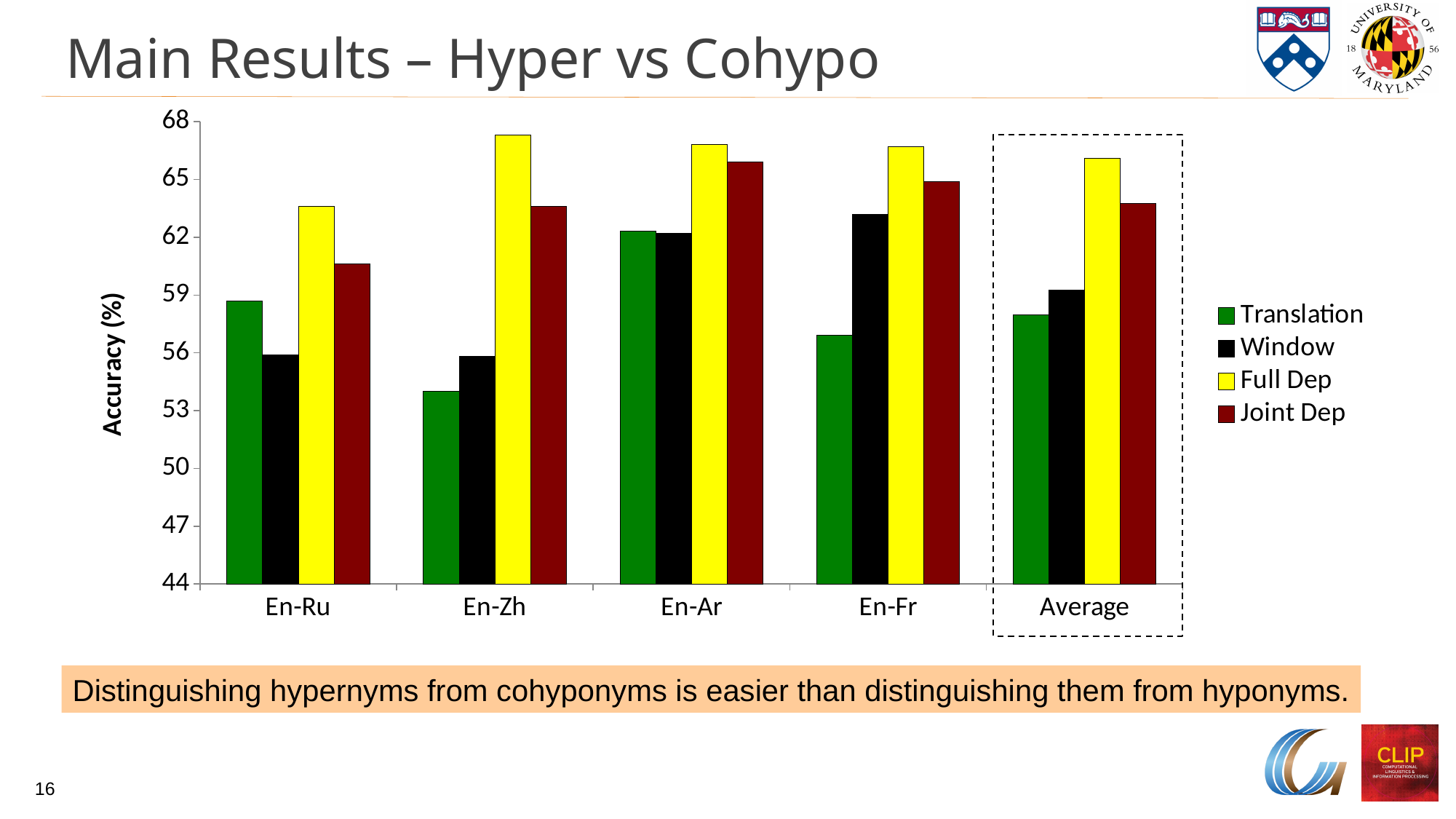
Is the Translation value for En-Fr greater or less than 59? less For En-Fr, which is larger: the Window value or the Translation value? Window How many categories are shown on the x axis? 5 Is the Translation value for En-Ru greater or less than 56? greater Which series has the highest value for the Average category? Full Dep Which category has the lowest Translation value? En-Zh Is the Joint Dep value for En-Ru greater or less than 59? greater For En-Ru, which is larger: the Full Dep value or the Joint Dep value? Full Dep How many series does the legend list? 4 What kind of chart is shown on the slide? bar chart What is the label of the y axis? Accuracy (%)